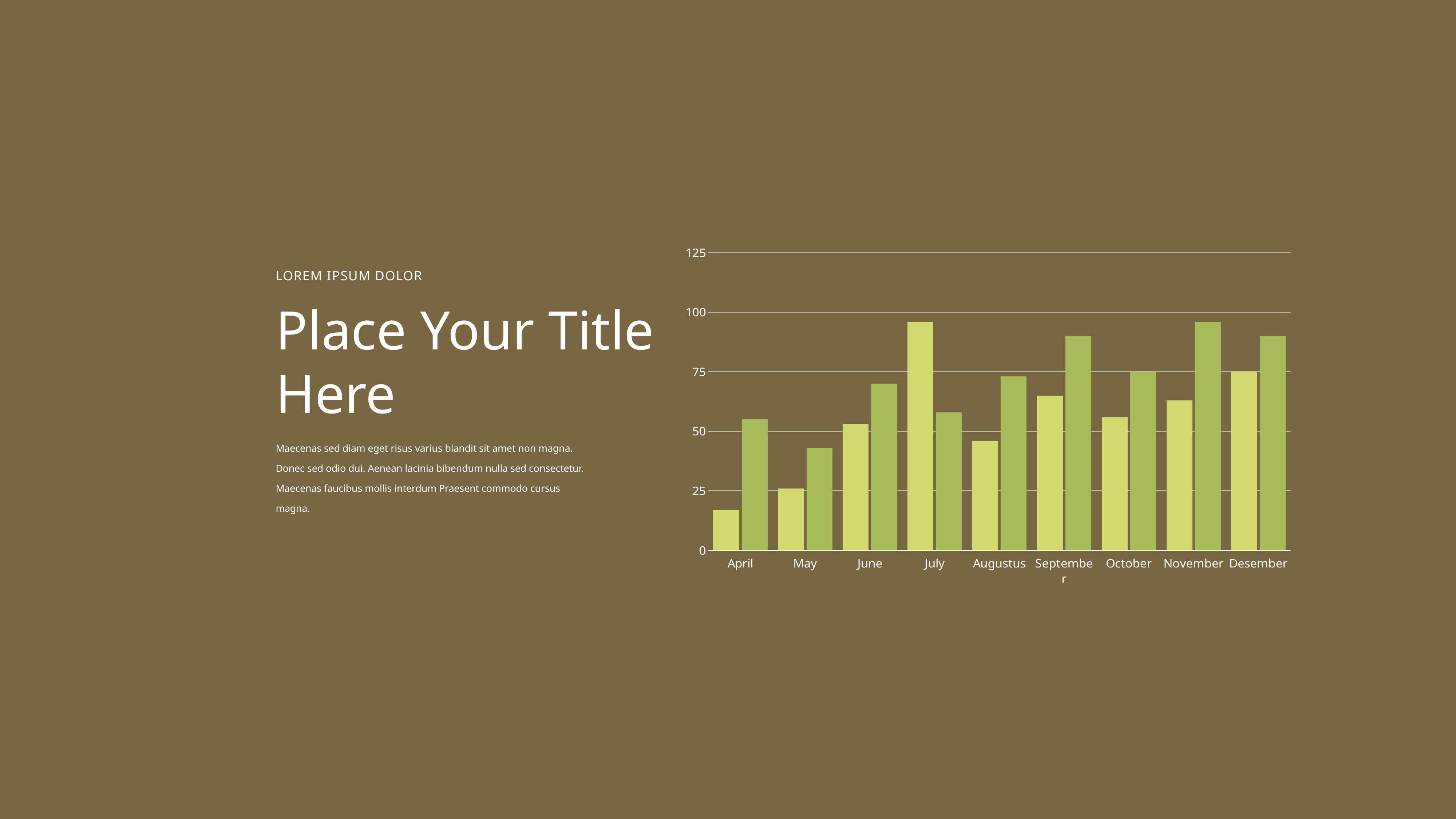
Which month has the tallest light yellow-green (left) bar? July Which month has the shortest light yellow-green (left) bar? April How many bars are plotted for each month in the chart? 2 Is the darker green (right) bar for May greater or less than 50? less In April, which bar is taller: the light yellow-green bar or the darker green bar? the darker green bar Do the light yellow-green (left) bars rise or fall from April to July? rise Is the light yellow-green (left) bar for April greater or less than 25? less What kind of chart is shown on the slide? bar chart Is the light yellow-green (left) bar for July greater or less than 75? greater Which month has the shortest darker green (right) bar? May How many categories (months) are shown on the x axis of the chart? 9